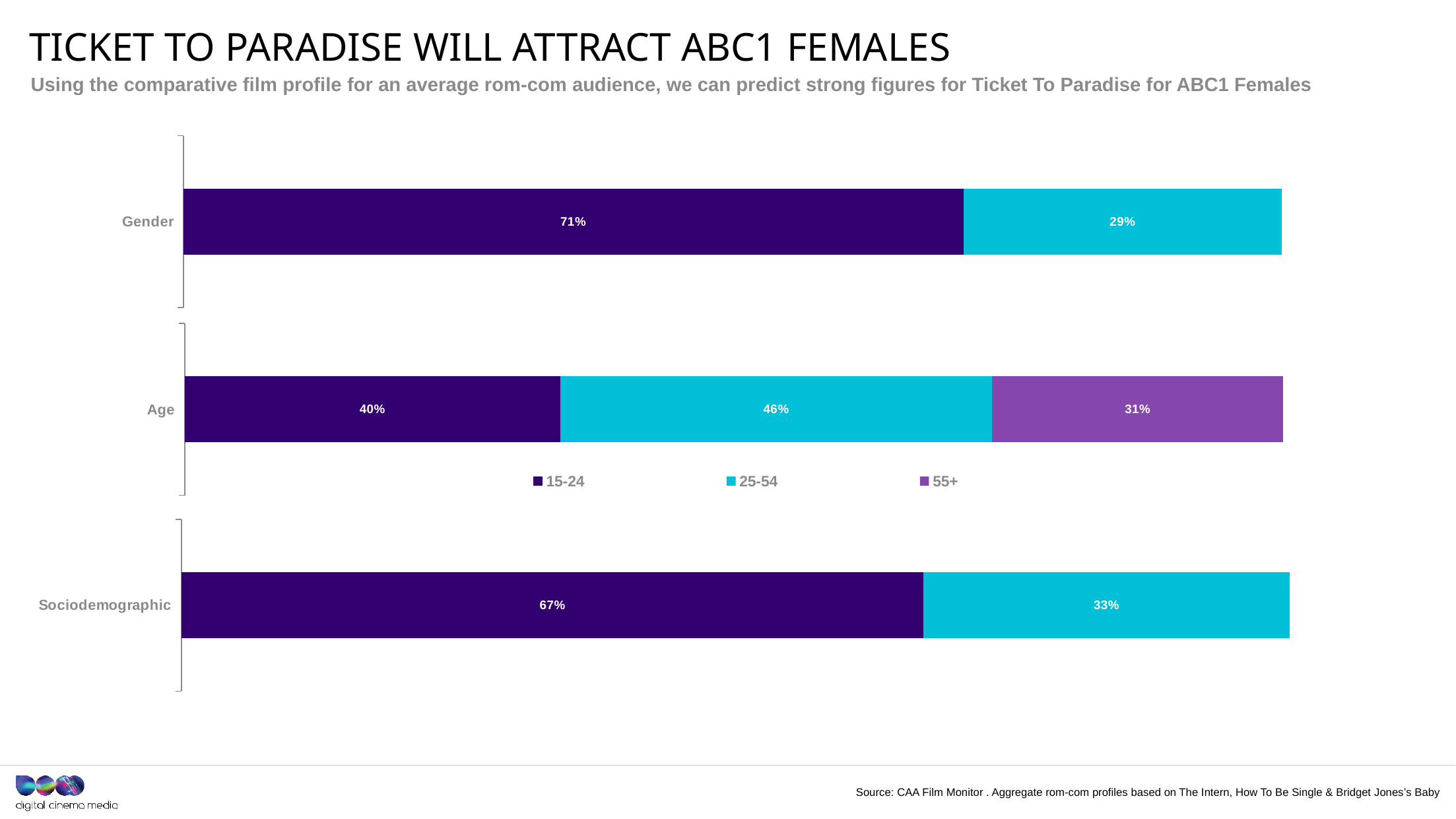
Which age group has the largest share in the Age bar? 25-54 What kind of chart is shown on the slide? bar chart Which is larger in the Age bar: the 15-24 segment or the 55+ segment? 15-24 What is the value of the 25-54 segment in the Age bar? 46% How many entries does the legend list? 3 What is the difference between the two segments of the Gender bar? 42% Which age group has the smallest share in the Age bar? 55+ What is the value of the dark purple segment in the Gender bar? 71% What is the value of the light blue segment in the Sociodemographic bar? 33% How many category bars are plotted on the chart? 3 What is the value of the 55+ segment in the Age bar? 31% What is the value of the 15-24 segment in the Age bar? 40%